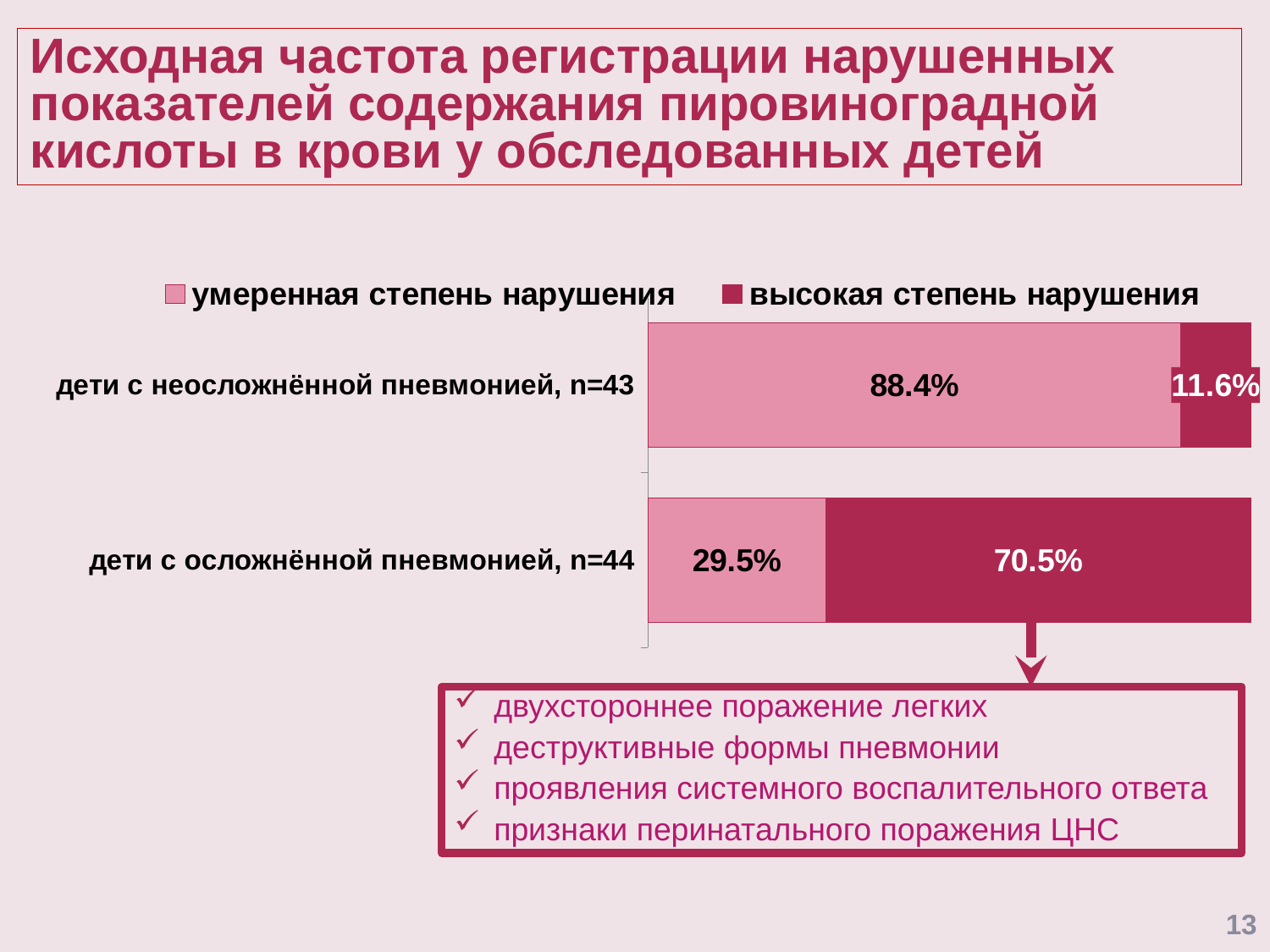
For 'дети с осложнённой пневмонией, n=44', which is larger: 'умеренная степень нарушения' or 'высокая степень нарушения'? высокая степень нарушения What is the total of the stacked bar for 'дети с неосложнённой пневмонией, n=43'? 100% What is the value of 'высокая степень нарушения' for 'дети с неосложнённой пневмонией, n=43'? 11.6% Which category has the lowest value for 'умеренная степень нарушения'? дети с осложнённой пневмонией, n=44 What is the value of 'умеренная степень нарушения' for 'дети с осложнённой пневмонией, n=44'? 29.5% What is the value of 'высокая степень нарушения' for 'дети с осложнённой пневмонией, n=44'? 70.5% What type of chart is shown on the slide? stacked bar chart Which category has the highest value for 'высокая степень нарушения'? дети с осложнённой пневмонией, n=44 What is the difference between the 'высокая степень нарушения' values for 'дети с осложнённой пневмонией, n=44' and 'дети с неосложнённой пневмонией, n=43'? 58.9% What is the value of 'умеренная степень нарушения' for 'дети с неосложнённой пневмонией, n=43'? 88.4% How many series does the legend list? 2 How many categories are plotted in the chart? 2